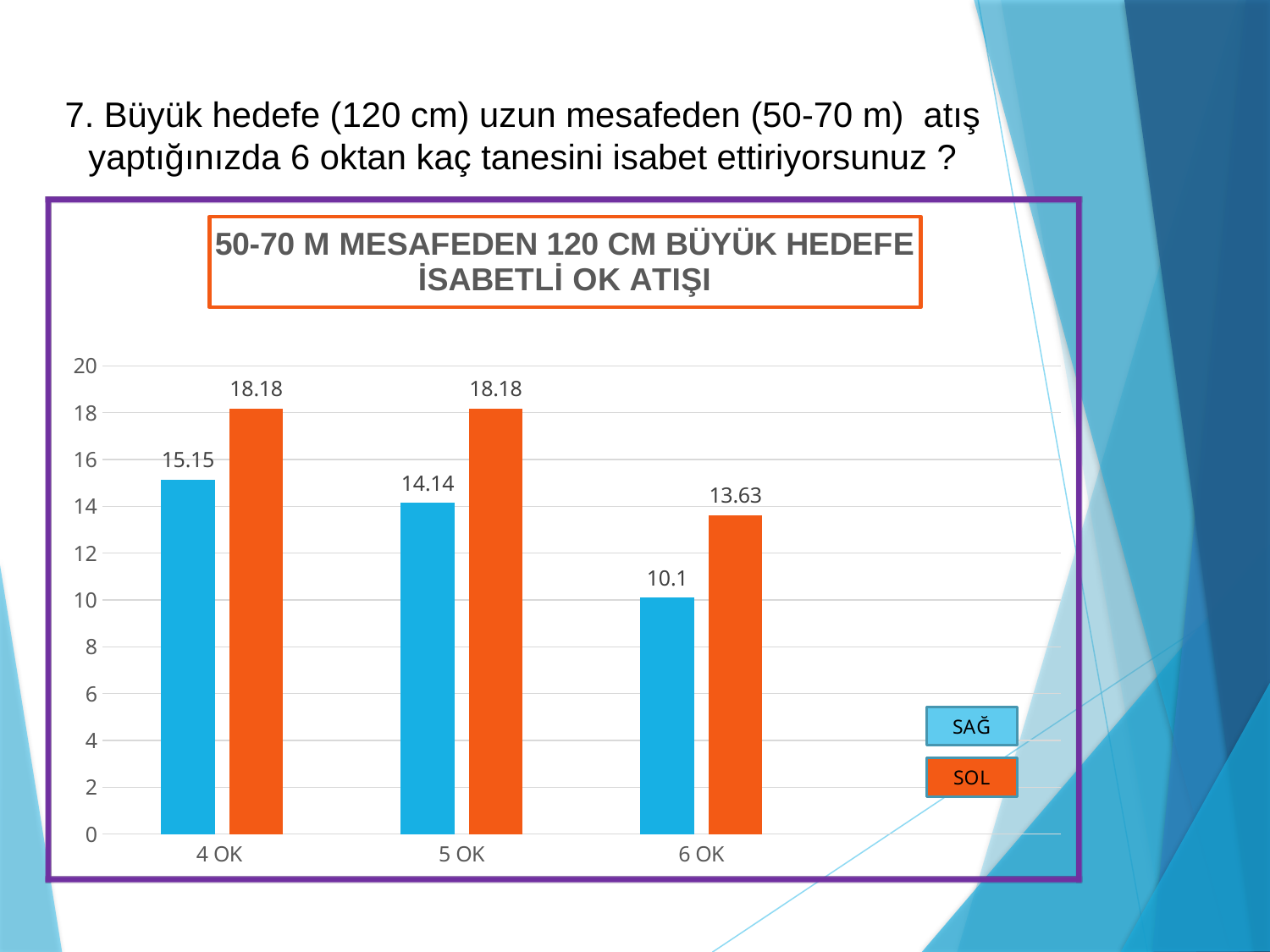
Which is larger for 5 OK, SAĞ or SOL? SOL What kind of chart is shown? bar chart Which category has the lowest SAĞ value? 6 OK Which category has the lowest SOL value? 6 OK What is the SAĞ value for 5 OK? 14.14 What is the SOL value for 6 OK? 13.63 What is the difference between the SOL and SAĞ values for 4 OK? 3.03 How many series does the legend list? 2 What is the difference between the SOL and SAĞ values for 6 OK? 3.53 Do the SAĞ values rise or fall from 4 OK to 6 OK? fall How many categories are shown on the x axis? 3 What is the SAĞ value for 4 OK? 15.15